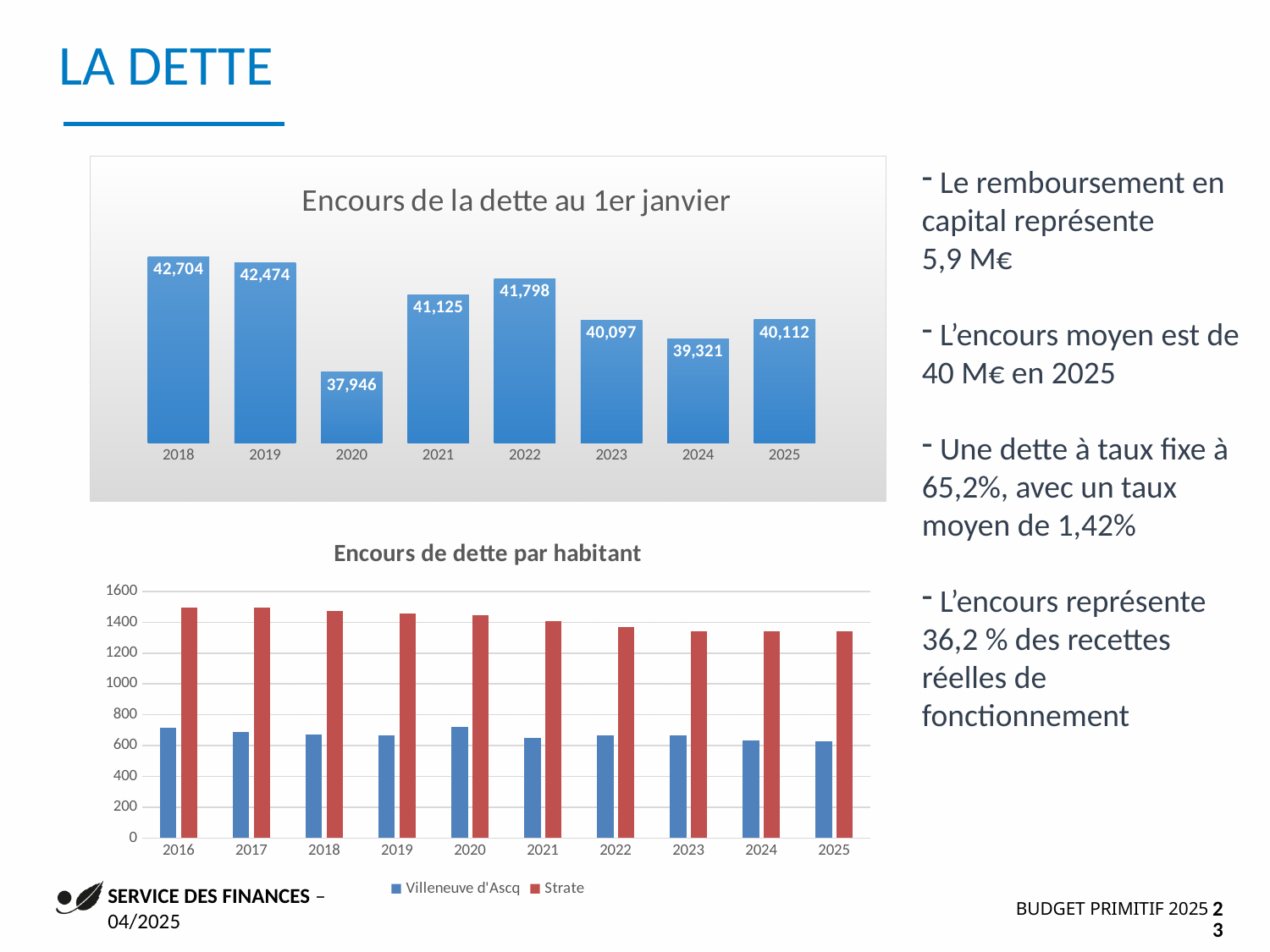
In the chart 'Encours de la dette au 1er janvier', what is the value for 2020? 37,946 How many series does the legend of the chart 'Encours de dette par habitant' list? 2 In the chart 'Encours de la dette au 1er janvier', which is larger, the value for 2021 or the value for 2022? 2022 In the chart 'Encours de dette par habitant', is the value for Villeneuve d'Ascq in 2025 greater or less than 800? less In the chart 'Encours de la dette au 1er janvier', which year has the highest value? 2018 In the chart 'Encours de dette par habitant', does the Strate series rise or fall from 2016 to 2025? fall In the chart 'Encours de la dette au 1er janvier', what is the value for 2025? 40,112 In the chart 'Encours de la dette au 1er janvier', which year has the lowest value? 2020 How many years are shown in the chart 'Encours de la dette au 1er janvier'? 8 In the chart 'Encours de dette par habitant', is the value for Strate in 2016 greater or less than 1400? greater In the chart 'Encours de la dette au 1er janvier', what is the difference between the values for 2018 and 2019? 230 What kind of chart is 'Encours de dette par habitant'? bar chart